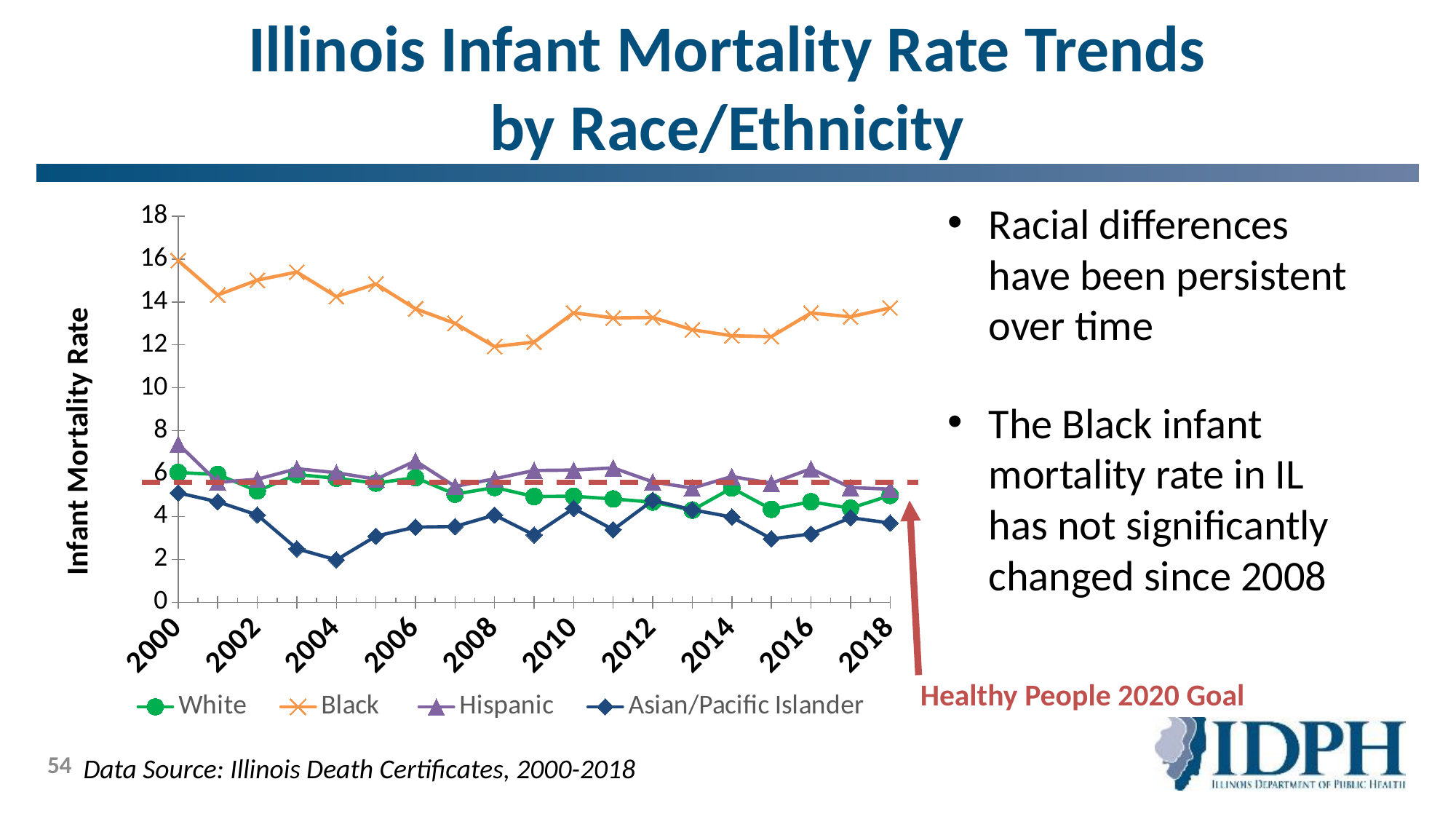
Which is larger in 2010, the infant mortality rate for Black or for White? Black Does the Black infant mortality rate rise or fall from 2000 to 2008? Fall What kind of chart is shown on the slide? Line chart Is the infant mortality rate for Black in 2018 greater or less than 12? greater What does the red dashed horizontal line on the chart represent? Healthy People 2020 Goal How many series does the chart legend list? 4 What is the label of the y axis? Infant Mortality Rate Is the infant mortality rate for Hispanic in 2000 greater or less than 6? greater Which race/ethnicity series has the highest infant mortality rate across the whole period? Black Is the infant mortality rate for Black in 2000 greater or less than 14? greater Which series has the lowest infant mortality rate in 2004? Asian/Pacific Islander